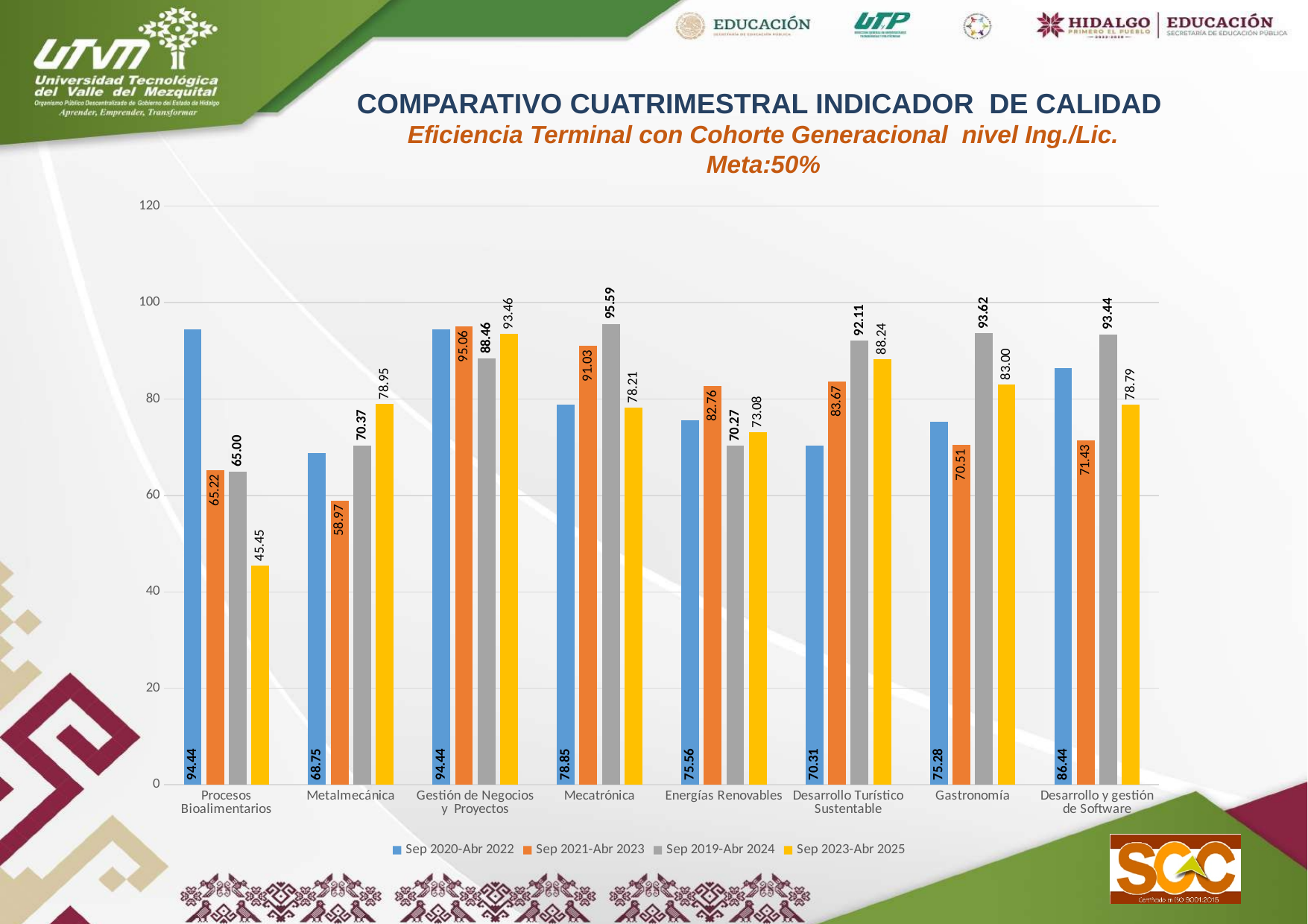
For Gastronomía, which series has the larger value: Sep 2019-Abr 2024 or Sep 2023-Abr 2025? Sep 2019-Abr 2024 What is the value for Mecatrónica in the Sep 2019-Abr 2024 series? 95.59 Which category has the lowest value in the Sep 2019-Abr 2024 series? Procesos Bioalimentarios How many categories (programs) are shown on the x axis of the chart? 8 For Metalmecánica, what is the difference between the Sep 2023-Abr 2025 value and the Sep 2021-Abr 2023 value? 19.98 What is the value for Procesos Bioalimentarios in the Sep 2023-Abr 2025 series? 45.45 How many series does the chart legend list? 4 Which category has the highest value in the Sep 2021-Abr 2023 series? Gestión de Negocios y Proyectos For Desarrollo Turístico Sustentable, how much higher is the Sep 2019-Abr 2024 value than the Sep 2020-Abr 2022 value? 21.80 Which category has the lowest value in the Sep 2023-Abr 2025 series? Procesos Bioalimentarios What type of chart is shown on the slide? Bar chart What is the value for Desarrollo y gestión de Software in the Sep 2020-Abr 2022 series? 86.44